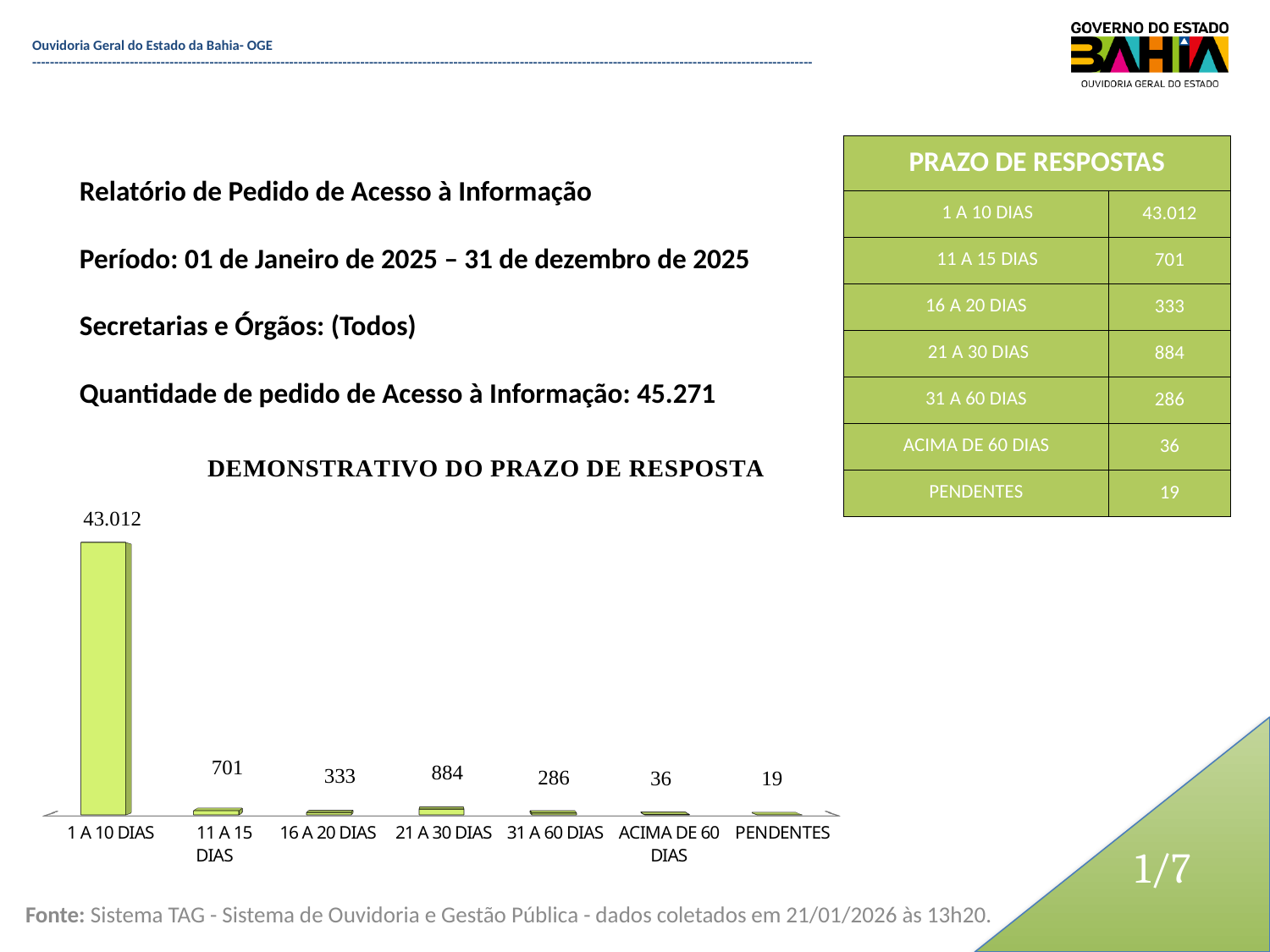
What is the difference between the values for 21 A 30 DIAS and 11 A 15 DIAS? 183 Which category has the highest value in the chart? 1 A 10 DIAS What is the value for ACIMA DE 60 DIAS in the chart? 36 Which category has the lowest value in the chart? PENDENTES How many categories are shown in the chart? 7 What is the value for 21 A 30 DIAS in the chart? 884 What is the value for 1 A 10 DIAS in the chart? 43.012 What is the value for PENDENTES in the chart? 19 What is the title of the chart? DEMONSTRATIVO DO PRAZO DE RESPOSTA What kind of chart is shown on the slide? bar chart Which is larger, the value for 11 A 15 DIAS or the value for 16 A 20 DIAS? 11 A 15 DIAS What is the difference between the values for 16 A 20 DIAS and 31 A 60 DIAS? 47